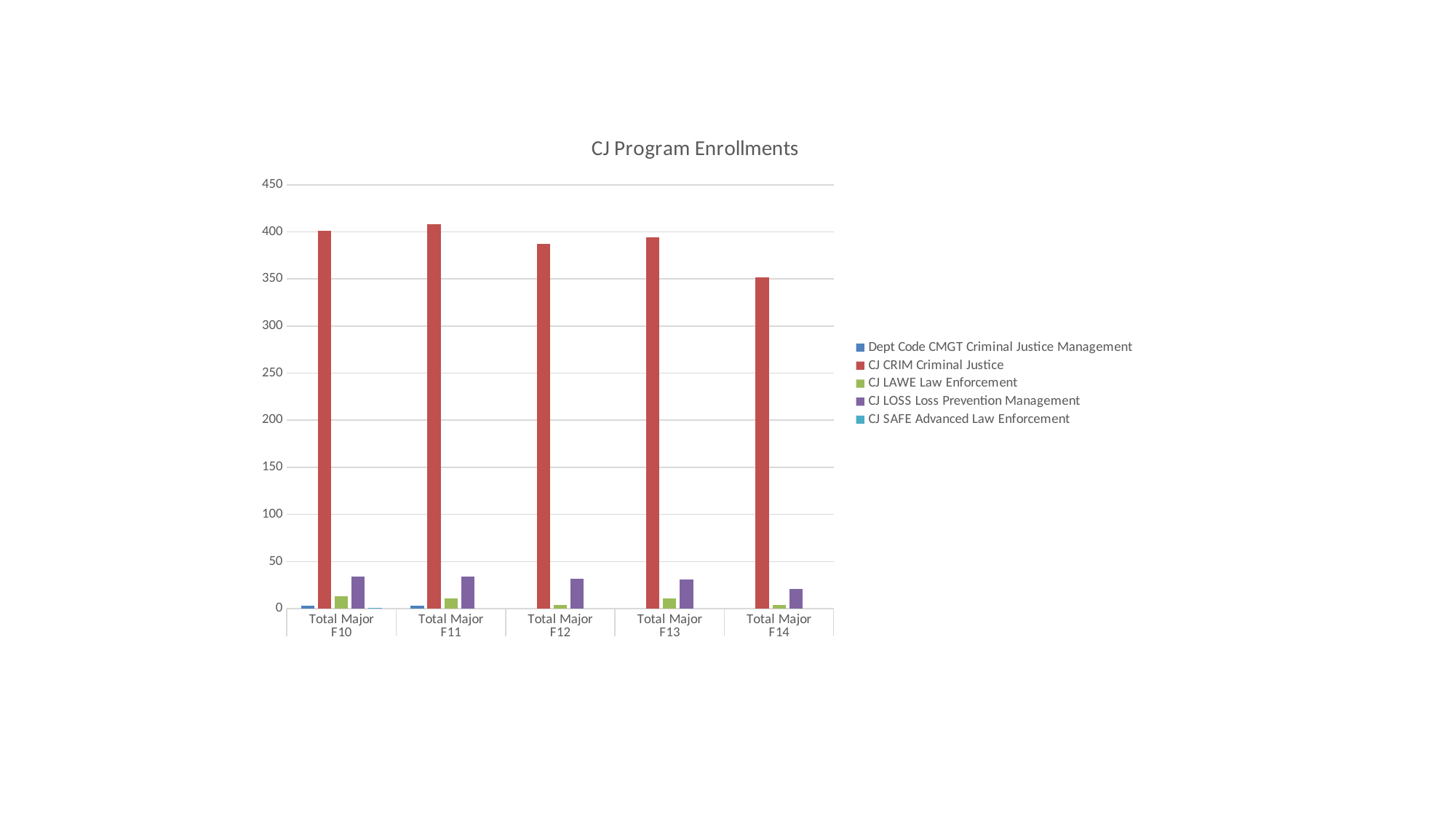
What kind of chart is shown on the slide? bar chart How many categories are shown on the x axis? 5 In which category is the CJ CRIM Criminal Justice bar lowest? Total Major F14 Does the CJ CRIM Criminal Justice value rise or fall from Total Major F13 to Total Major F14? fall In Total Major F12, which is larger, CJ LOSS Loss Prevention Management or CJ LAWE Law Enforcement? CJ LOSS Loss Prevention Management Which is larger, the CJ CRIM Criminal Justice value in Total Major F13 or in Total Major F14? Total Major F13 Is the value for CJ LOSS Loss Prevention Management in Total Major F14 greater or less than 50? less Is the value for CJ CRIM Criminal Justice in Total Major F11 greater or less than 400? greater What is the title of the chart? CJ Program Enrollments Which series has the highest bars in every category? CJ CRIM Criminal Justice How many series does the legend list? 5 Is the value for CJ CRIM Criminal Justice in Total Major F14 greater or less than 400? less